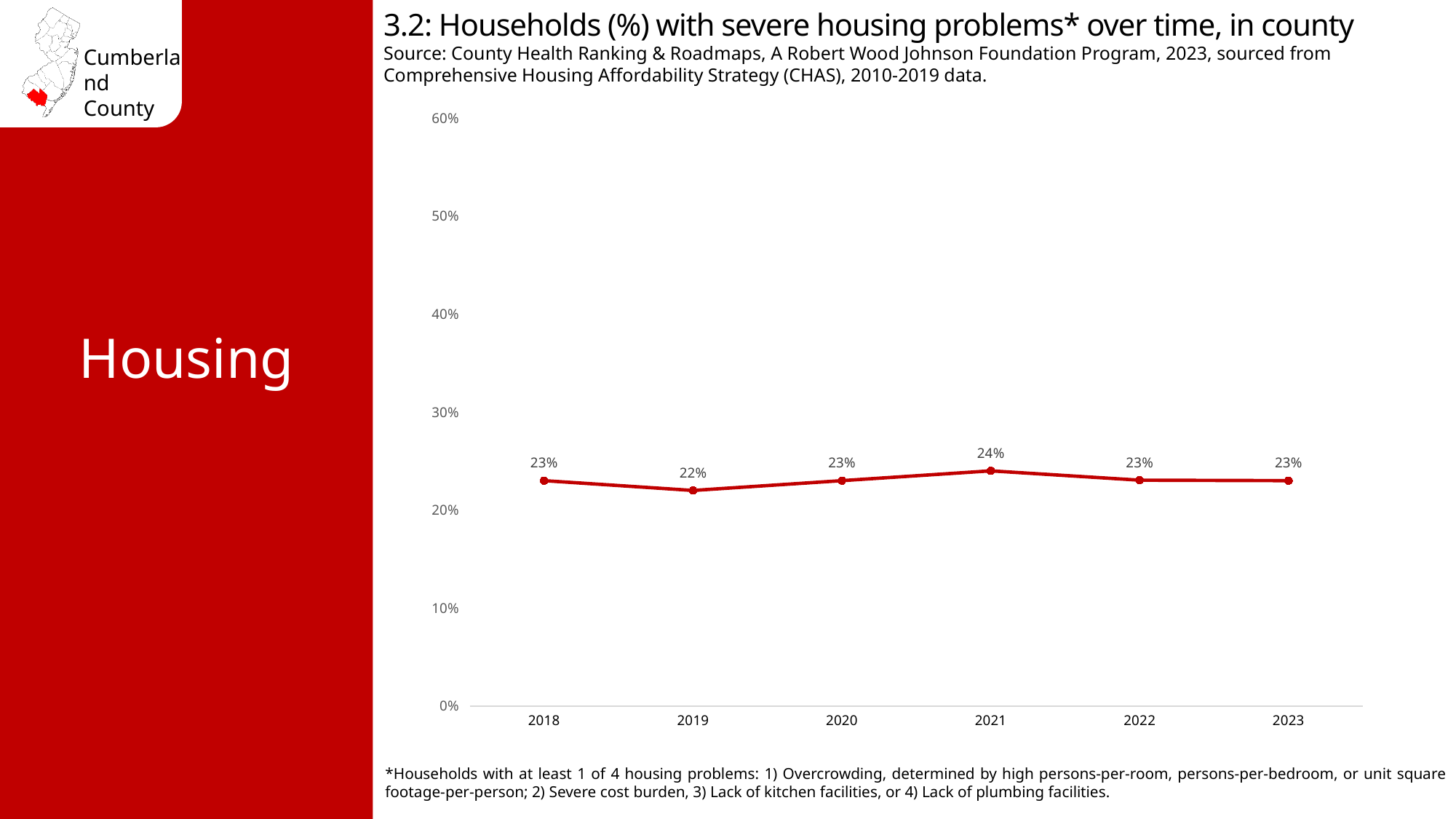
Is the value for 2021 greater or less than 30%? less What percentage of households had severe housing problems in 2023? 23% What is the title of the chart? 3.2: Households (%) with severe housing problems* over time, in county Which year has the highest percentage of households with severe housing problems? 2021 What percentage of households had severe housing problems in 2018? 23% Is the value for 2019 greater or less than 20%? greater How many years are plotted on the chart? 6 What is the difference in percentage points between 2021 and 2019? 2 Which year has the lowest percentage of households with severe housing problems? 2019 What percentage of households had severe housing problems in 2021? 24% What percentage of households had severe housing problems in 2019? 22% What kind of chart is shown on the slide? line chart